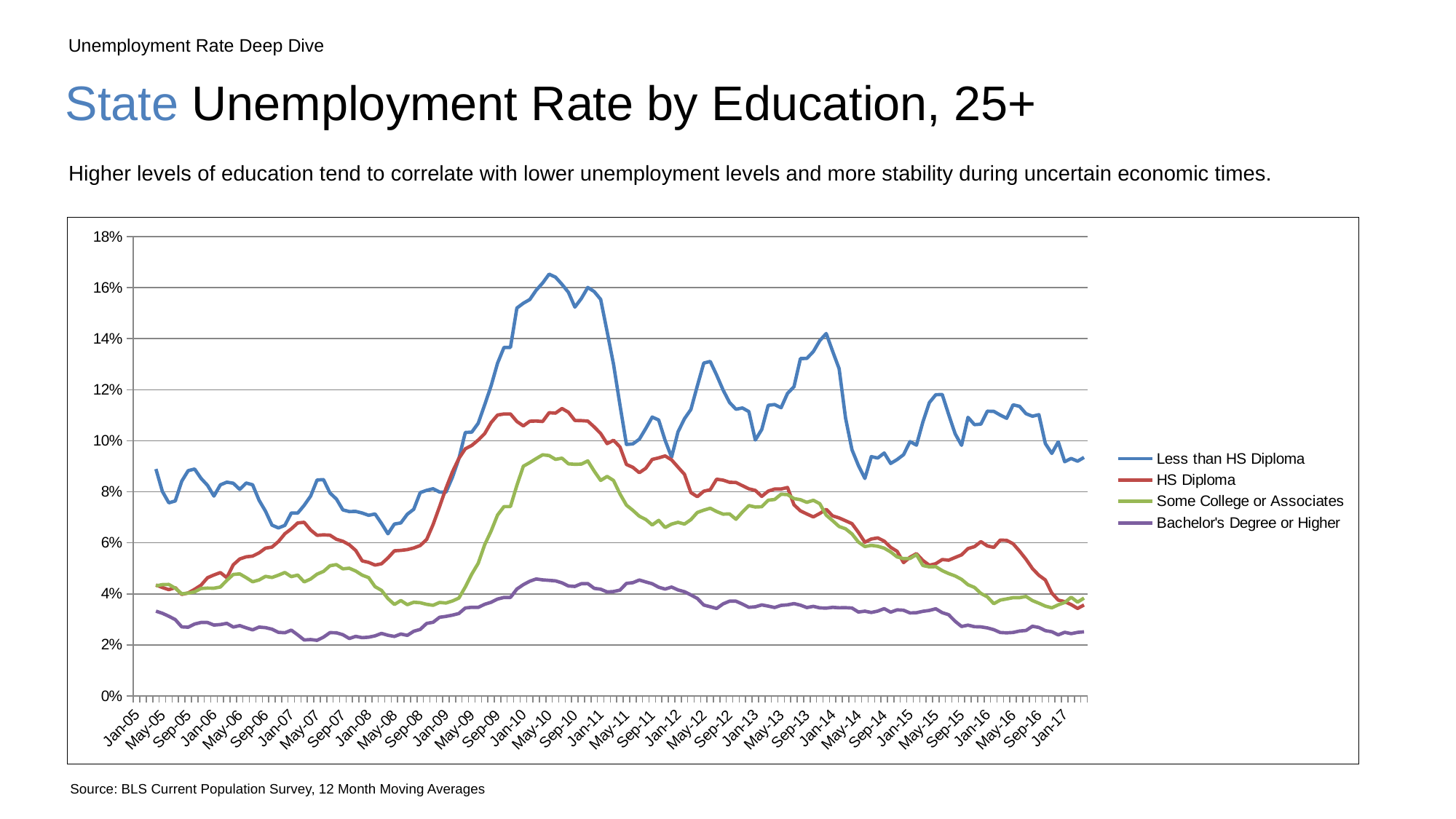
Around Jan-14, which is higher: Less than HS Diploma or HS Diploma? Less than HS Diploma Which education group has the highest unemployment rate across the whole period? Less than HS Diploma Between May-13 and Jan-17, does the HS Diploma line rise or fall overall? fall Is the peak value for Less than HS Diploma greater or less than 16%? greater Between Jan-08 and May-10, does the Less than HS Diploma line rise or fall? rise Is the highest value reached by Bachelor's Degree or Higher greater or less than 6%? less Which education group has the lowest unemployment rate across the whole period? Bachelor's Degree or Higher Which series is drawn in purple? Bachelor's Degree or Higher What kind of chart is shown on the slide? line chart Around May-10, is the value for HS Diploma greater or less than 10%? greater How many series does the legend list? 4